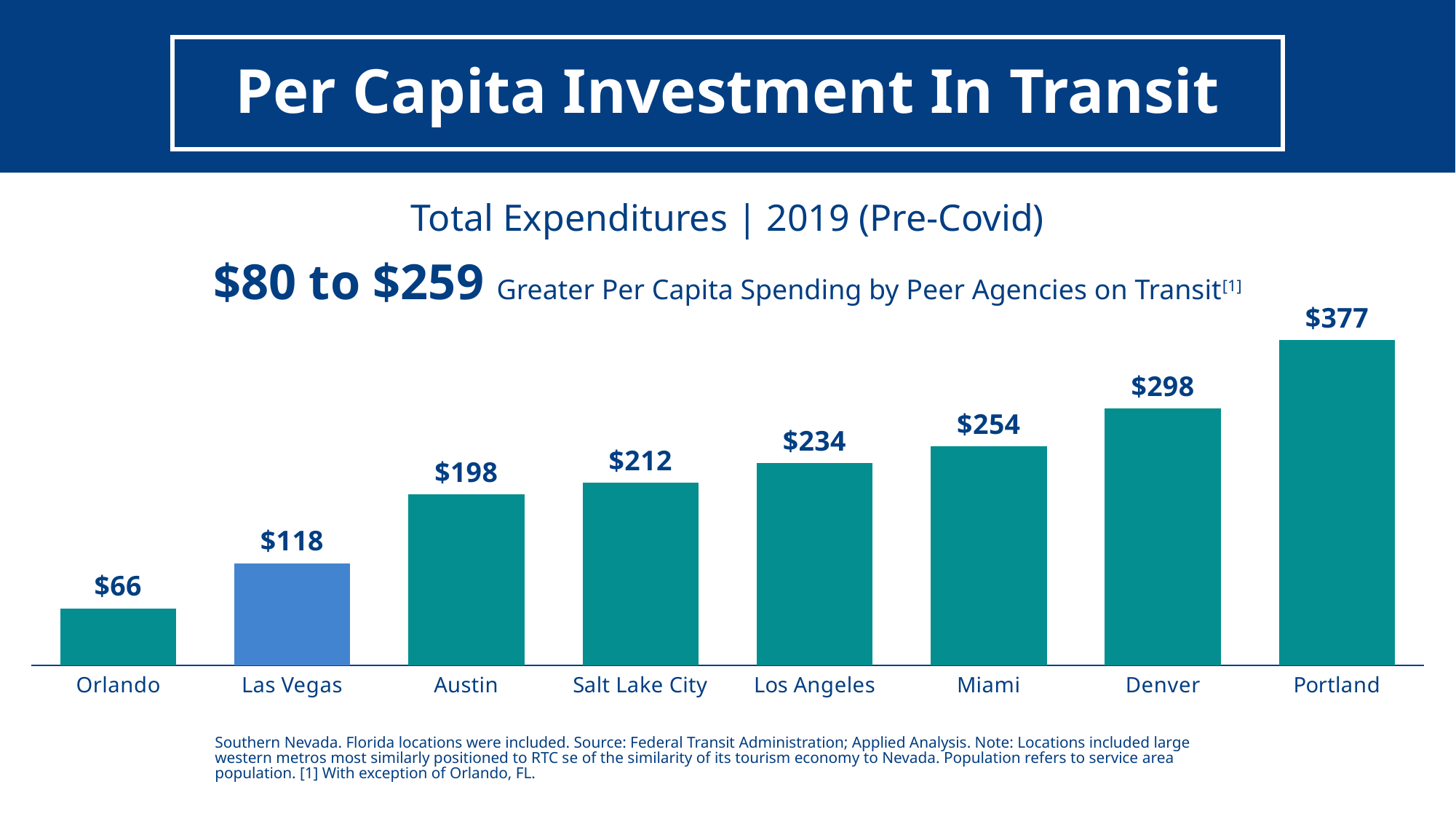
What is the per capita transit expenditure for Denver? $298 Which has a higher per capita transit expenditure, Los Angeles or Austin? Los Angeles What kind of chart is shown on the slide? Bar chart Which city has the highest per capita transit expenditure? Portland How many cities are shown in the chart? 8 Do the values rise or fall from left to right across the cities? Rise Which city has the lowest per capita transit expenditure? Orlando Which city's bar is shown in a different colour (blue) from the others? Las Vegas What is the per capita transit expenditure for Salt Lake City? $212 What is the per capita transit expenditure for Las Vegas? $118 What is the difference between Miami's and Austin's per capita transit expenditure? $56 What is the difference between Portland's and Las Vegas's per capita transit expenditure? $259